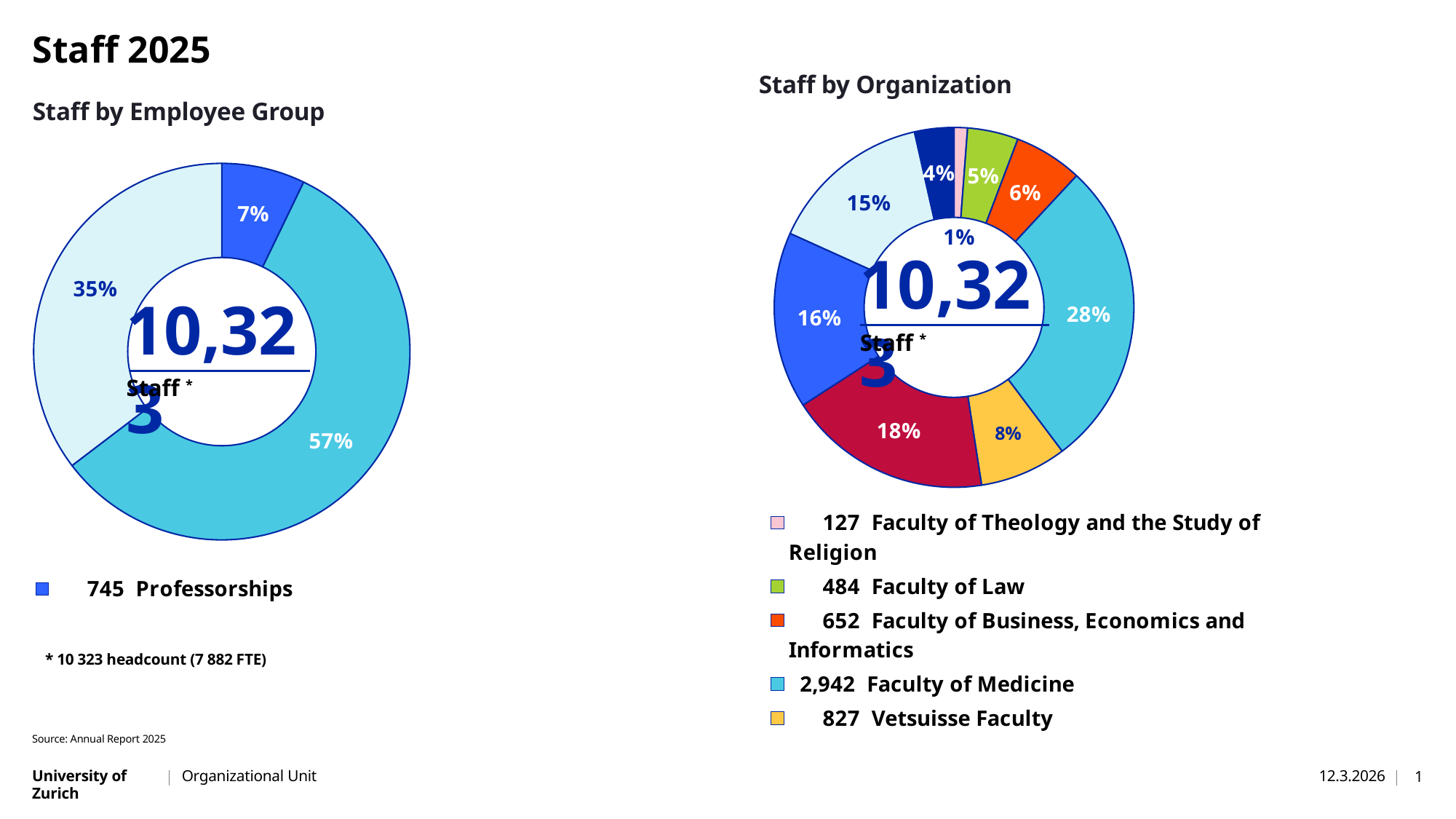
What kind of chart is the Staff by Employee Group chart? Pie (donut) chart In the Staff by Employee Group chart, what share of staff is Professorships? 7% In the Staff by Organization chart, which listed faculty has the largest share? Faculty of Medicine In the Staff by Employee Group chart, what is the largest slice's share? 57% How many slices does the Staff by Employee Group chart have? 3 How many slices does the Staff by Organization chart have? 9 In the Staff by Organization chart, what is the difference in percentage points between the Faculty of Medicine (28%) and the Vetsuisse Faculty (8%)? 20 percentage points In the Staff by Organization chart, how many staff does the Faculty of Law have? 484 In the Staff by Organization chart, what share of staff is the Faculty of Medicine? 28% In the Staff by Organization chart, which listed faculty has the smallest share? Faculty of Theology and the Study of Religion In the Staff by Organization chart, which has the larger share: the Faculty of Law or the Faculty of Business, Economics and Informatics? Faculty of Business, Economics and Informatics In the Staff by Employee Group chart, how many staff are Professorships according to the legend? 745